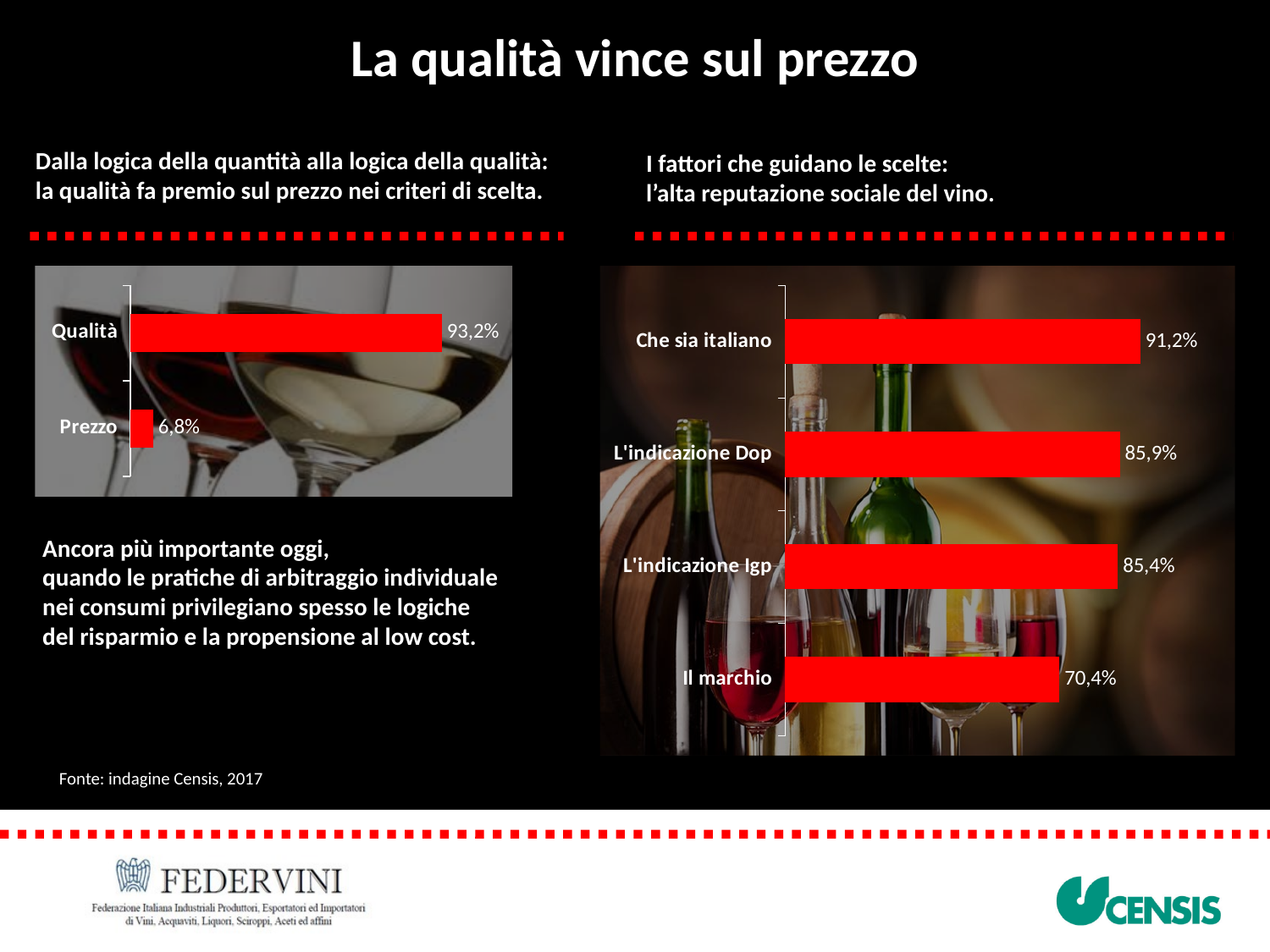
In the chart on the right, what is the value for L'indicazione Dop? 85,9% In the chart on the left, what is the value for Prezzo? 6,8% In the chart on the right, how many categories are shown? 4 In the chart on the right, what is the value for Il marchio? 70,4% In the chart on the right, which category has the highest value? Che sia italiano In the chart on the left, what is the value for Qualità? 93,2% In the chart on the left, how many categories are shown? 2 What kind of chart is the chart on the left? Bar chart In the chart on the right, what is the value for Che sia italiano? 91,2% In the chart on the left, what is the difference between the values for Qualità and Prezzo? 86,4 percentage points In the chart on the right, what is the difference between the values for Che sia italiano and Il marchio? 20,8 percentage points In the chart on the right, which category has the lowest value? Il marchio